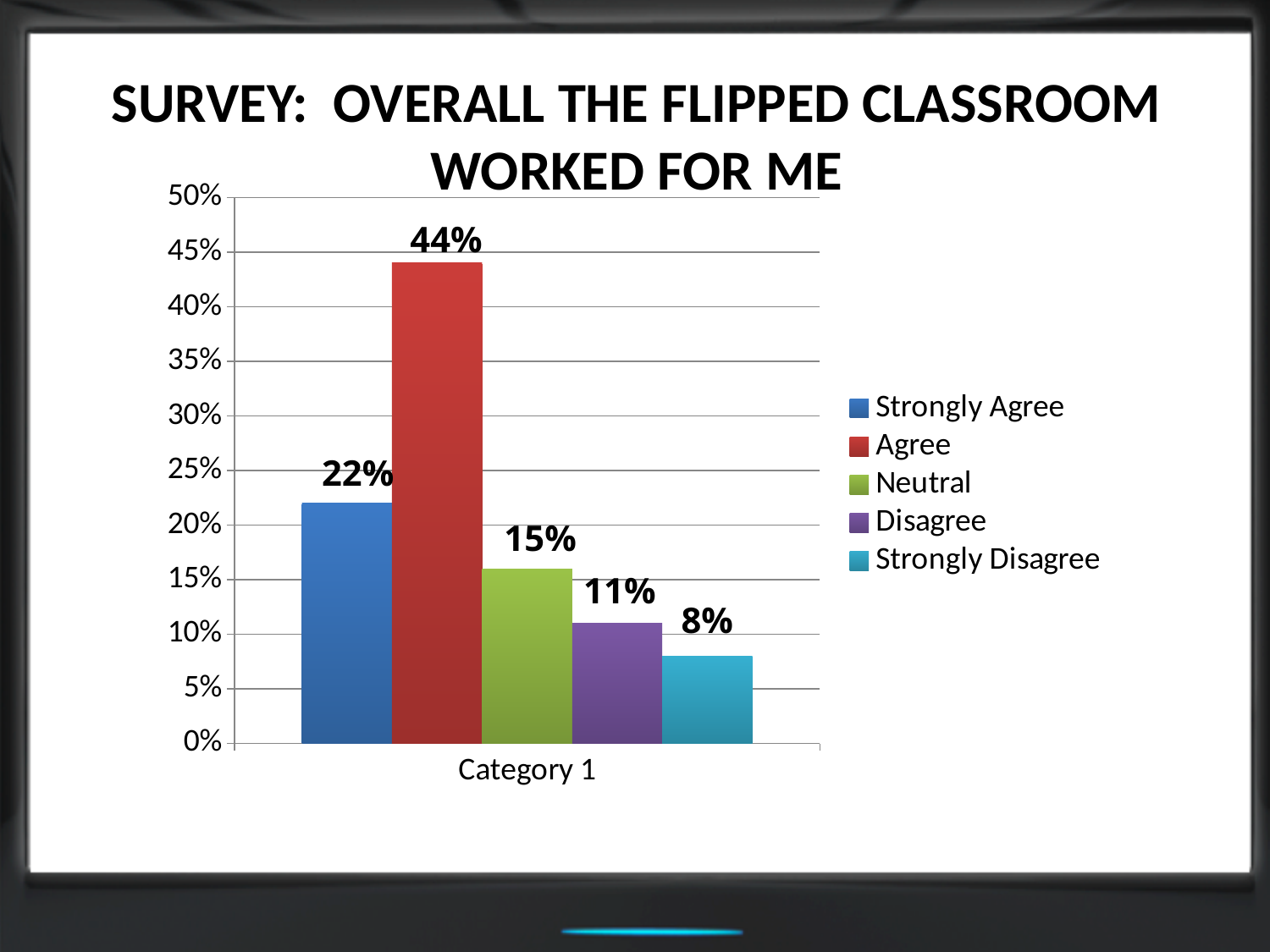
Which is larger, the percentage for Neutral or the percentage for Disagree? Neutral What is the difference in percentage points between Neutral and Disagree? 4% What percentage of respondents chose Agree? 44% What is the label on the x axis under the bars? Category 1 How many series does the legend list? 5 What colour is the bar for Agree? Red Which response option has the highest percentage? Agree Which response option has the lowest percentage? Strongly Disagree What is the difference in percentage points between Agree and Strongly Agree? 22% What percentage of respondents chose Strongly Disagree? 8% What percentage of respondents chose Strongly Agree? 22% What kind of chart is shown on the slide? Bar chart